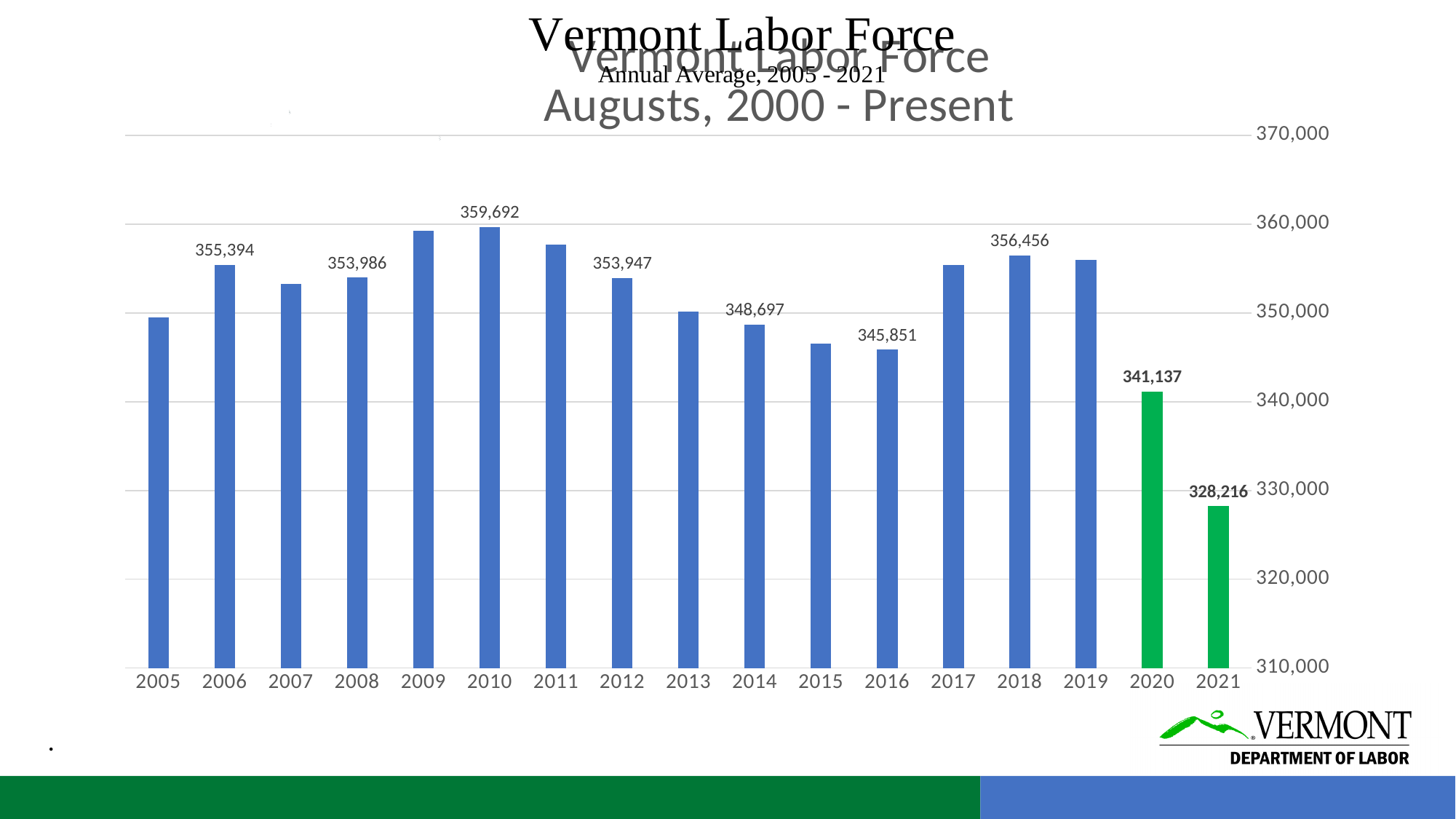
Which year has the lowest value? 2021 What is the difference between the values for 2020 and 2021? 12,921 Is the value for 2015 greater or less than 350,000? less What is the difference between the values for 2010 and 2018? 3,236 What kind of chart is shown on the slide? bar chart What is the value for 2010? 359,692 Which year has the highest value? 2010 Which is larger, the value for 2006 or the value for 2016? 2006 What is the value for 2020? 341,137 How many years are shown on the x axis? 17 What is the value for 2021? 328,216 What is the value for 2016? 345,851